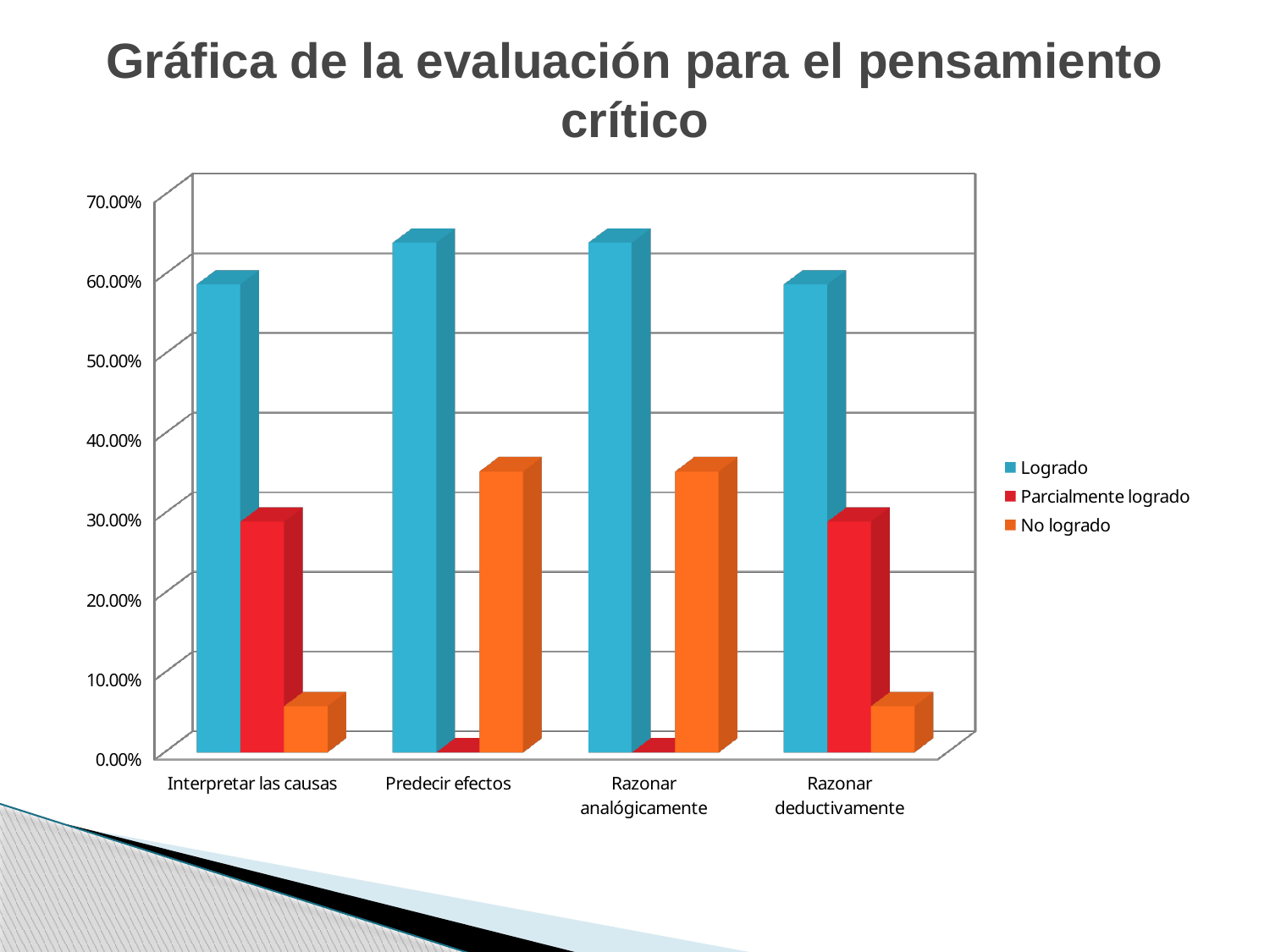
Is the Logrado value for Interpretar las causas greater or less than 50%? greater How many series does the chart's legend list? 3 Which series has the lowest value for Razonar analógicamente? Parcialmente logrado What is the title of the chart on the slide? Gráfica de la evaluación para el pensamiento crítico For Interpretar las causas, which is larger: Parcialmente logrado or No logrado? Parcialmente logrado Is the No logrado value for Predecir efectos greater or less than 30%? greater How many categories are shown on the x axis of the chart? 4 What kind of chart is shown on the slide? bar chart Is the No logrado value for Interpretar las causas greater or less than 10%? less For Predecir efectos, which is larger: Logrado or No logrado? Logrado